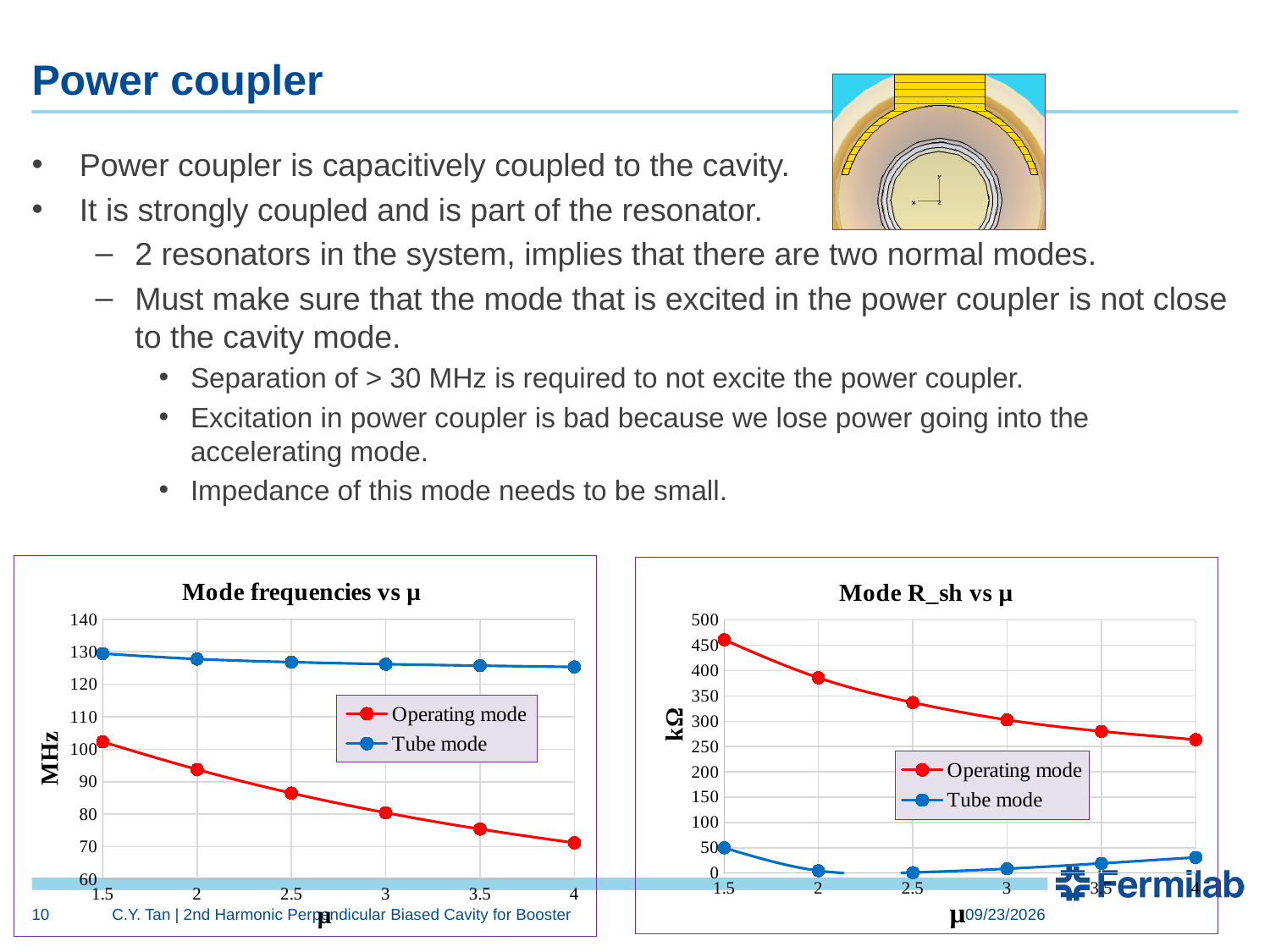
In the 'Mode frequencies vs μ' chart, does the Operating mode frequency rise or fall as μ increases? Fall In the 'Mode frequencies vs μ' chart, at which μ value is the Operating mode frequency highest? 1.5 In the 'Mode R_sh vs μ' chart, at which μ value is the Tube mode value highest? 1.5 In the 'Mode frequencies vs μ' chart, what kind of chart is it? Line chart In the 'Mode frequencies vs μ' chart, how many data points does the Operating mode series have? 6 In the 'Mode R_sh vs μ' chart, is the Operating mode value at μ = 4 greater or less than 300? less In the 'Mode frequencies vs μ' chart, at μ = 2, which series has the larger value, Operating mode or Tube mode? Tube mode In the 'Mode R_sh vs μ' chart, does the Operating mode value rise or fall as μ increases? Fall In the 'Mode R_sh vs μ' chart, what is the label on the vertical axis? kΩ In the 'Mode R_sh vs μ' chart, is the Operating mode value at μ = 1.5 greater or less than 400? greater In the 'Mode frequencies vs μ' chart, how many series does the legend list? 2 In the 'Mode frequencies vs μ' chart, is the Operating mode value at μ = 4 greater or less than 80? less